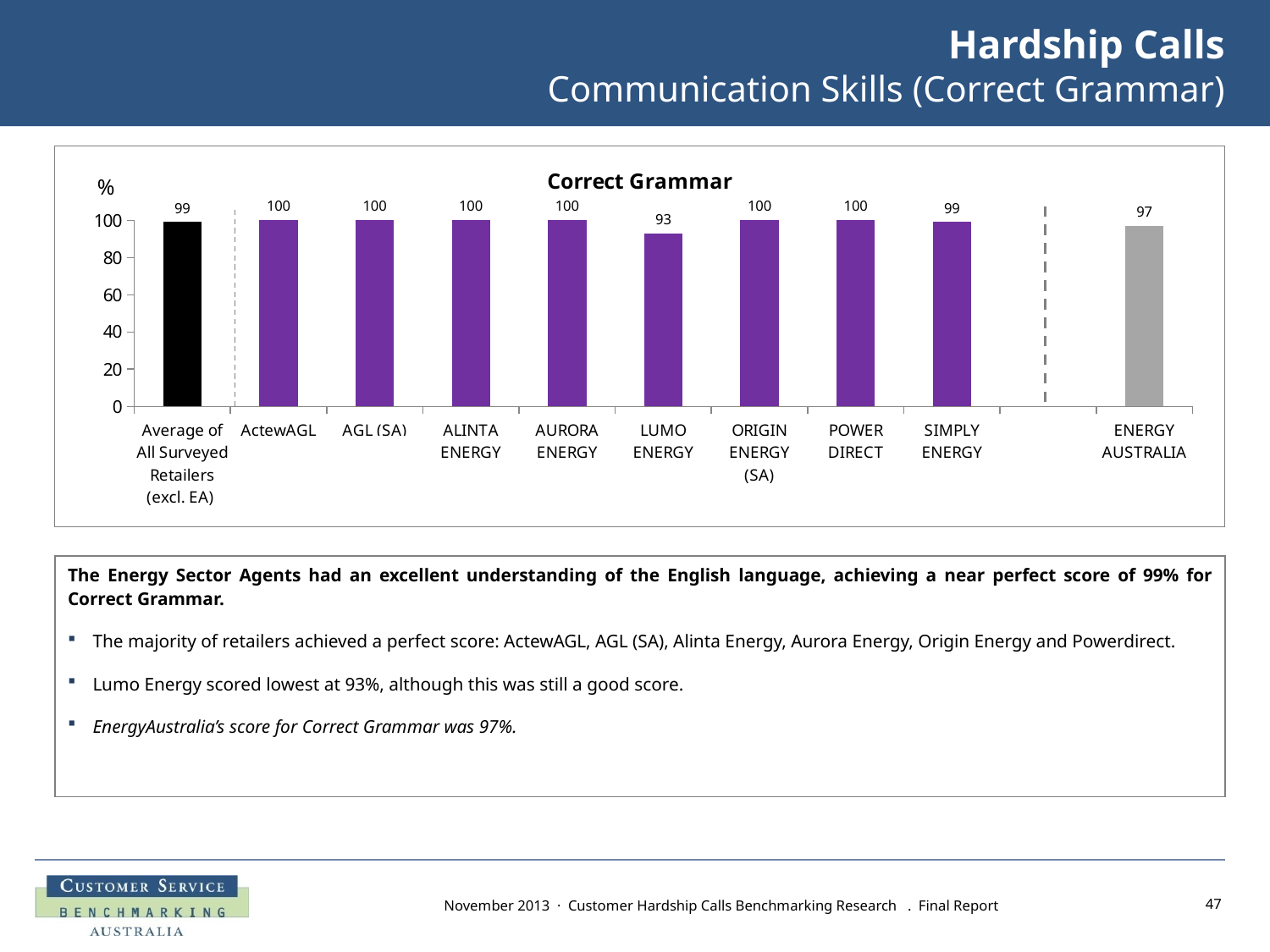
What is the difference between the values for ENERGY AUSTRALIA and LUMO ENERGY in the Correct Grammar chart? 4 What is the value for LUMO ENERGY in the Correct Grammar chart? 93 What kind of chart is the Correct Grammar chart? bar chart What is the difference between the values for ActewAGL and SIMPLY ENERGY in the Correct Grammar chart? 1 Which category has the lowest value in the Correct Grammar chart? LUMO ENERGY Which is larger in the Correct Grammar chart, the value for POWER DIRECT or the value for LUMO ENERGY? POWER DIRECT What is the value for Average of All Surveyed Retailers (excl. EA) in the Correct Grammar chart? 99 What is the value for ENERGY AUSTRALIA in the Correct Grammar chart? 97 What is the value for SIMPLY ENERGY in the Correct Grammar chart? 99 What is the title of the chart on the slide? Correct Grammar Is the value for LUMO ENERGY in the Correct Grammar chart greater or less than 80? greater How many categories are shown in the Correct Grammar chart? 10